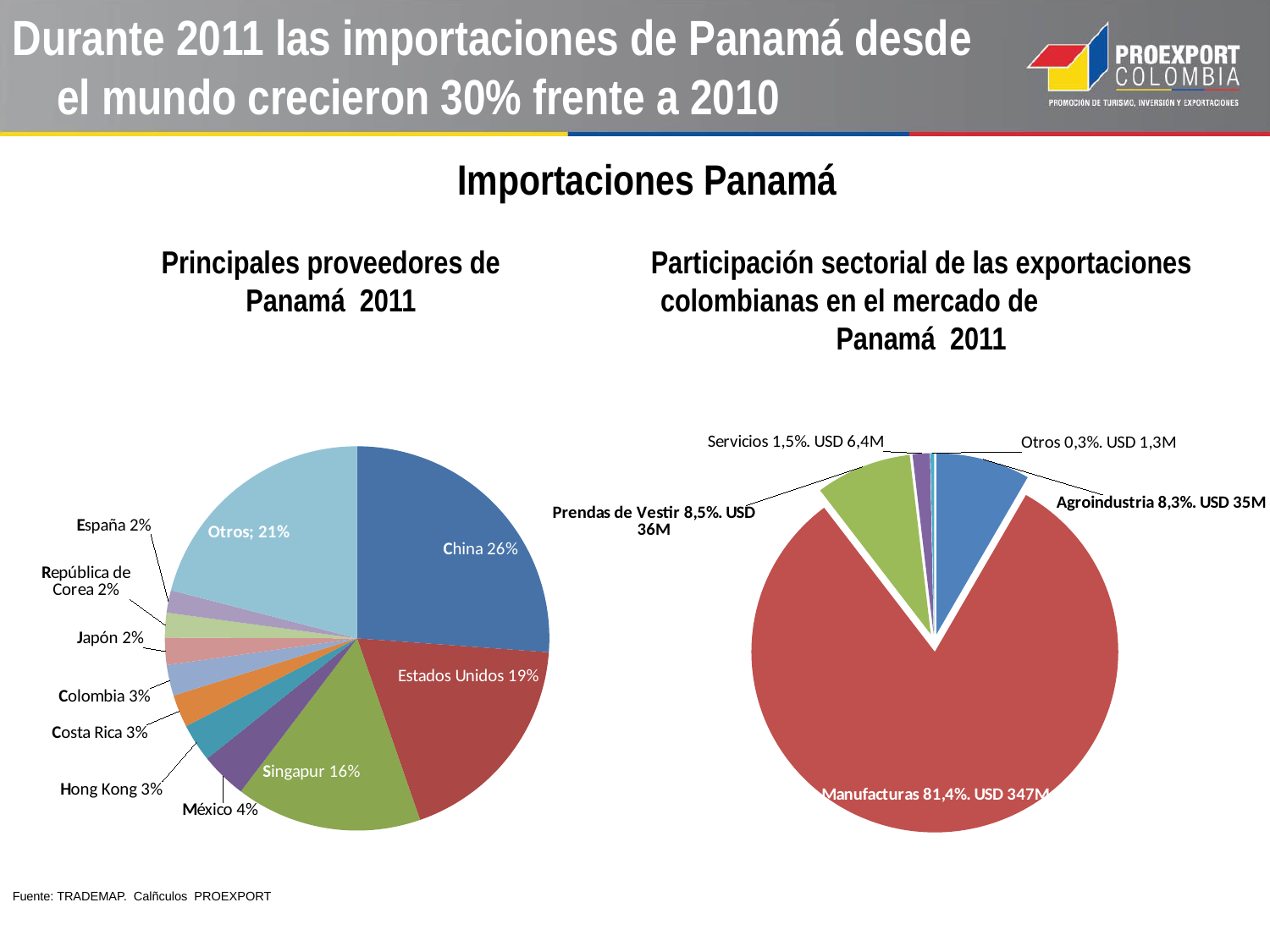
In the 'Principales proveedores de Panamá 2011' chart, which is larger, the share of Estados Unidos or the share of Singapur? Estados Unidos In the 'Principales proveedores de Panamá 2011' chart, which named country has the largest share? China In the 'Principales proveedores de Panamá 2011' chart, what share does China have? 26% In the 'Participación sectorial de las exportaciones colombianas en el mercado de Panamá 2011' chart, what is the value for Manufacturas? 81,4%. USD 347M What type of chart is used for 'Principales proveedores de Panamá 2011'? Pie chart How many slices does the 'Participación sectorial de las exportaciones colombianas en el mercado de Panamá 2011' pie chart have? 5 In the 'Principales proveedores de Panamá 2011' chart, what is the difference in share between China and Estados Unidos? 7% In the 'Participación sectorial de las exportaciones colombianas en el mercado de Panamá 2011' chart, which sector has the smallest share? Otros How many slices does the 'Principales proveedores de Panamá 2011' pie chart have? 11 In the 'Participación sectorial de las exportaciones colombianas en el mercado de Panamá 2011' chart, what is the difference in USD between Prendas de Vestir and Agroindustria? USD 1M In the 'Participación sectorial de las exportaciones colombianas en el mercado de Panamá 2011' chart, what is the USD value for Agroindustria? USD 35M In the 'Principales proveedores de Panamá 2011' chart, what share does Singapur have? 16%